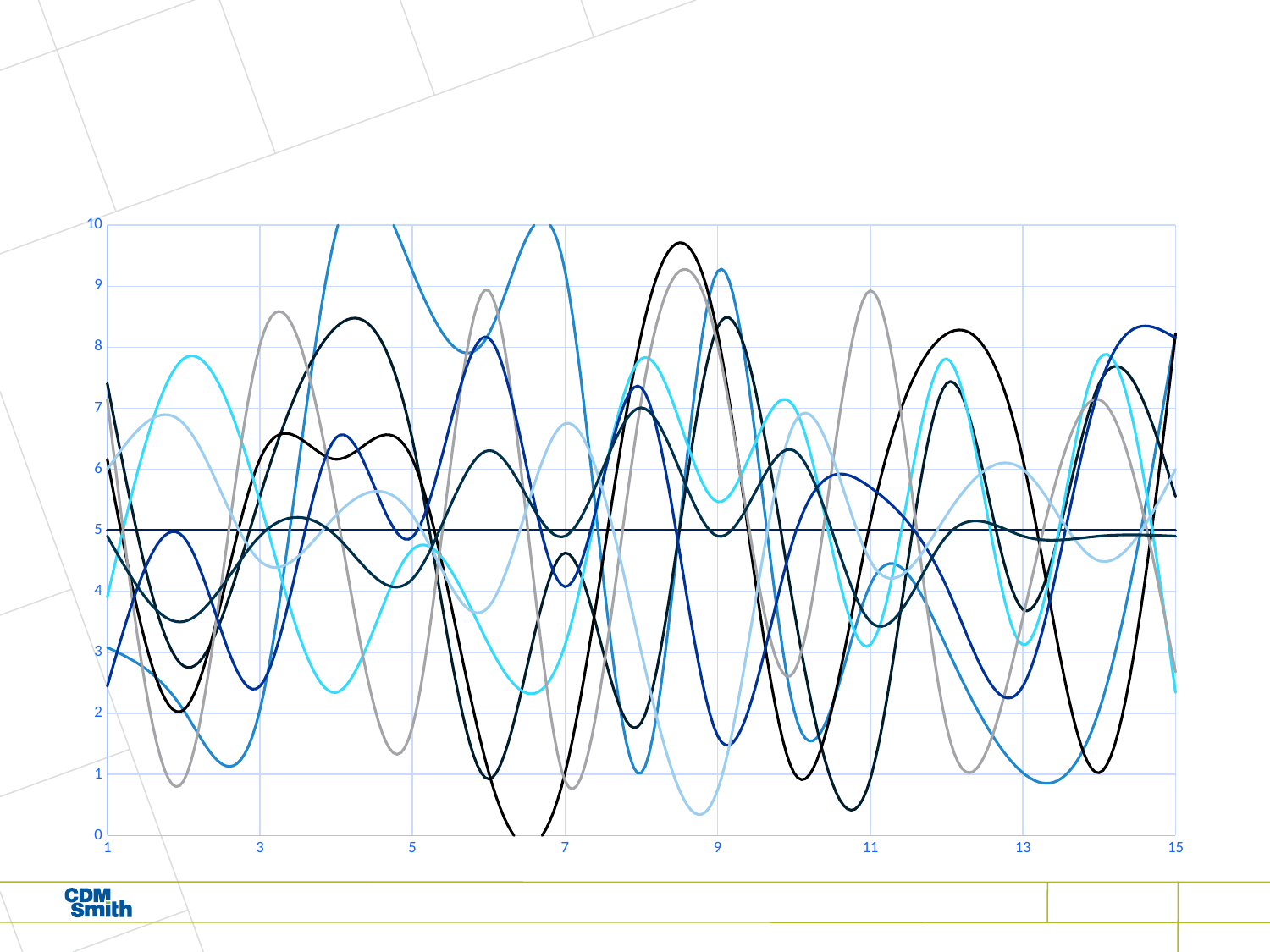
Does the chart have a legend? No What is the highest value labelled on the y-axis? 10 What kind of chart is shown on the slide? line chart What is the largest value labelled on the x-axis? 15 How many tick labels are shown along the x-axis? 8 What value does the flat horizontal line hold across the whole x-axis range? 5